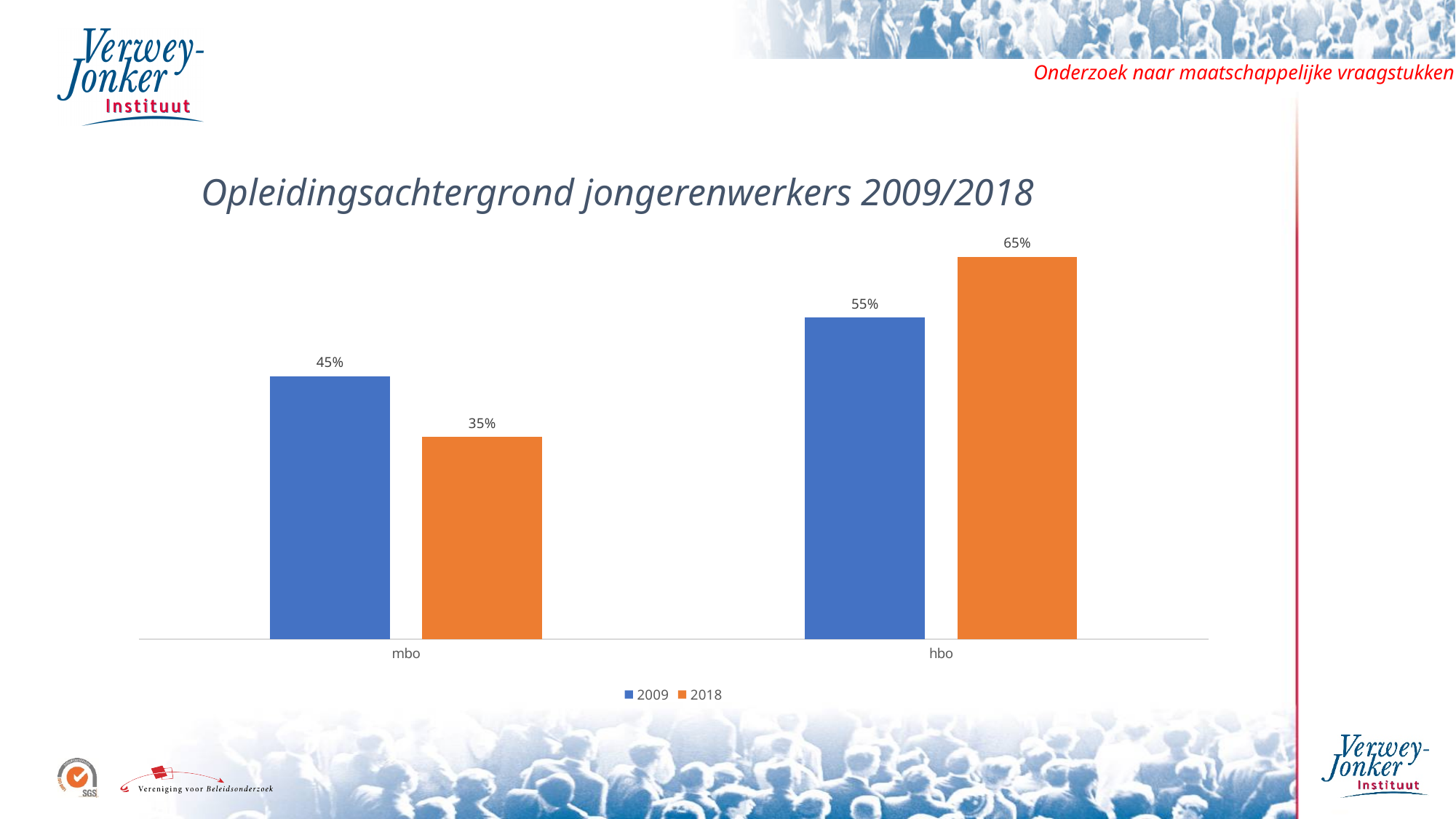
Which is larger: the 2009 value for hbo or the 2018 value for mbo? 2009 value for hbo What is the value for mbo in 2009? 45% Which category has the highest value in the 2018 series? hbo What is the difference between the hbo values for 2018 and 2009? 10% What is the value for mbo in 2018? 35% What is the value for hbo in 2009? 55% What is the value for hbo in 2018? 65% What is the difference between the mbo values for 2009 and 2018? 10% Which category has the lowest value in the 2009 series? mbo How many series does the legend list? 2 How many categories are shown on the x axis? 2 What kind of chart is shown on the slide? bar chart